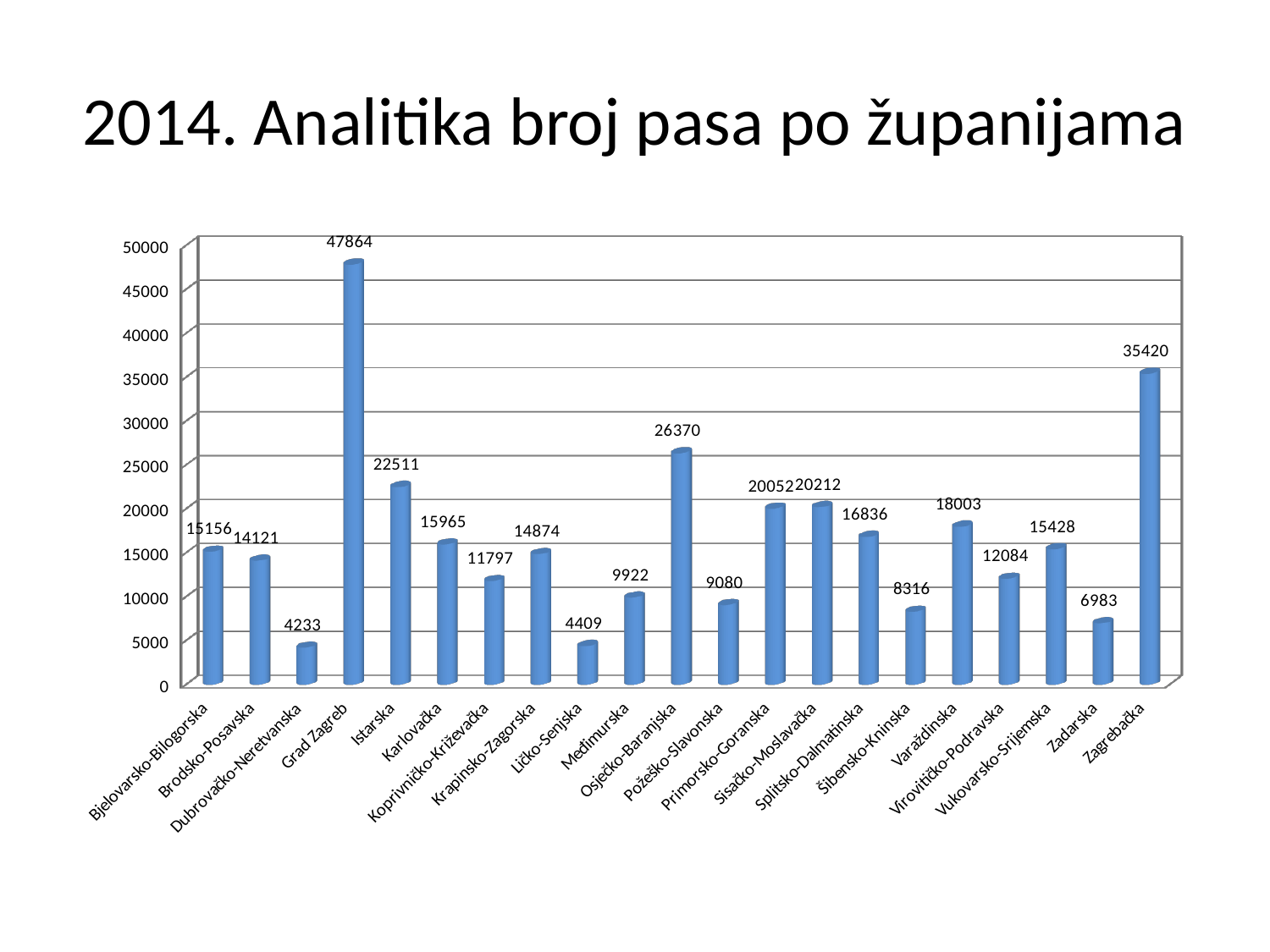
What is the value for Osječko-Baranjska? 26370 How many counties are shown on the x axis? 21 What is the difference between the values for Osječko-Baranjska and Istarska? 3859 What is the value for Grad Zagreb? 47864 What is the title of the slide? 2014. Analitika broj pasa po županijama What kind of chart is shown on the slide? bar chart What is the difference between the values for Grad Zagreb and Zagrebačka? 12444 Which county has the lowest value? Dubrovačko-Neretvanska Which is larger, the value for Varaždinska or for Splitsko-Dalmatinska? Varaždinska Is the value for Zagrebačka greater or less than 30000? greater What is the value for Šibensko-Kninska? 8316 Which county has the highest value? Grad Zagreb